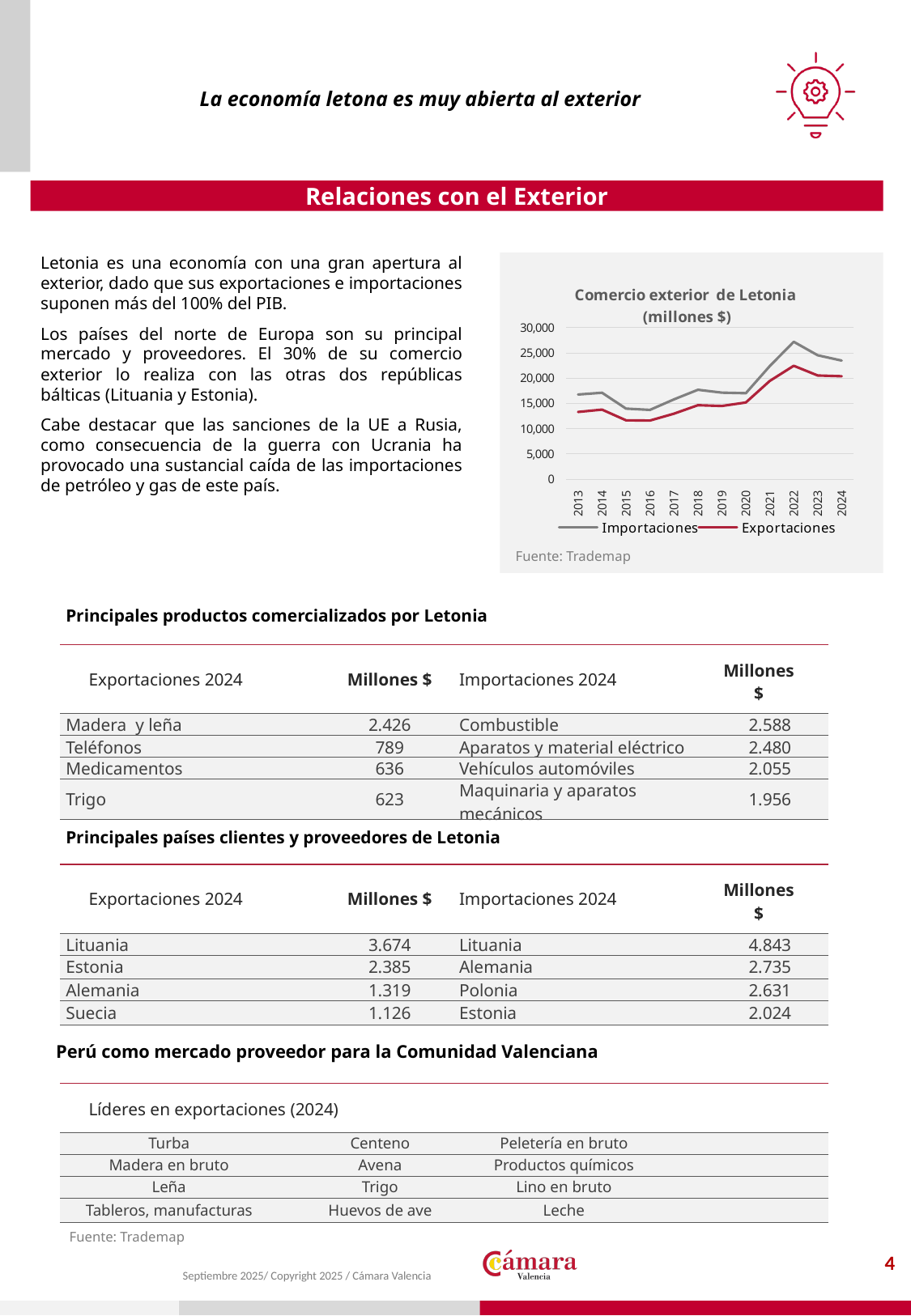
In the 'Comercio exterior de Letonia' chart, is the value for Importaciones in 2022 greater or less than 25,000? greater In the 'Comercio exterior de Letonia' chart, is the value for Exportaciones in 2022 greater or less than 20,000? greater How many years are plotted on the x axis of the 'Comercio exterior de Letonia' chart? 12 What kind of chart is 'Comercio exterior de Letonia (millones $)'? line chart Which two series are shown in the legend of the 'Comercio exterior de Letonia' chart? Importaciones and Exportaciones In the 'Comercio exterior de Letonia' chart, which series is higher in 2022, Importaciones or Exportaciones? Importaciones In the 'Comercio exterior de Letonia' chart, do the Exportaciones values rise or fall from 2016 to 2022? rise In the 'Comercio exterior de Letonia' chart, do the Importaciones values rise or fall from 2022 to 2024? fall In the 'Comercio exterior de Letonia' chart, which year is the first on the x axis and which is the last? 2013 and 2024 In the 'Comercio exterior de Letonia' chart, in which year does Importaciones reach its highest value? 2022 How many series does the legend of the 'Comercio exterior de Letonia' chart list? 2 In the 'Comercio exterior de Letonia' chart, is the value for Exportaciones in 2016 greater or less than 15,000? less